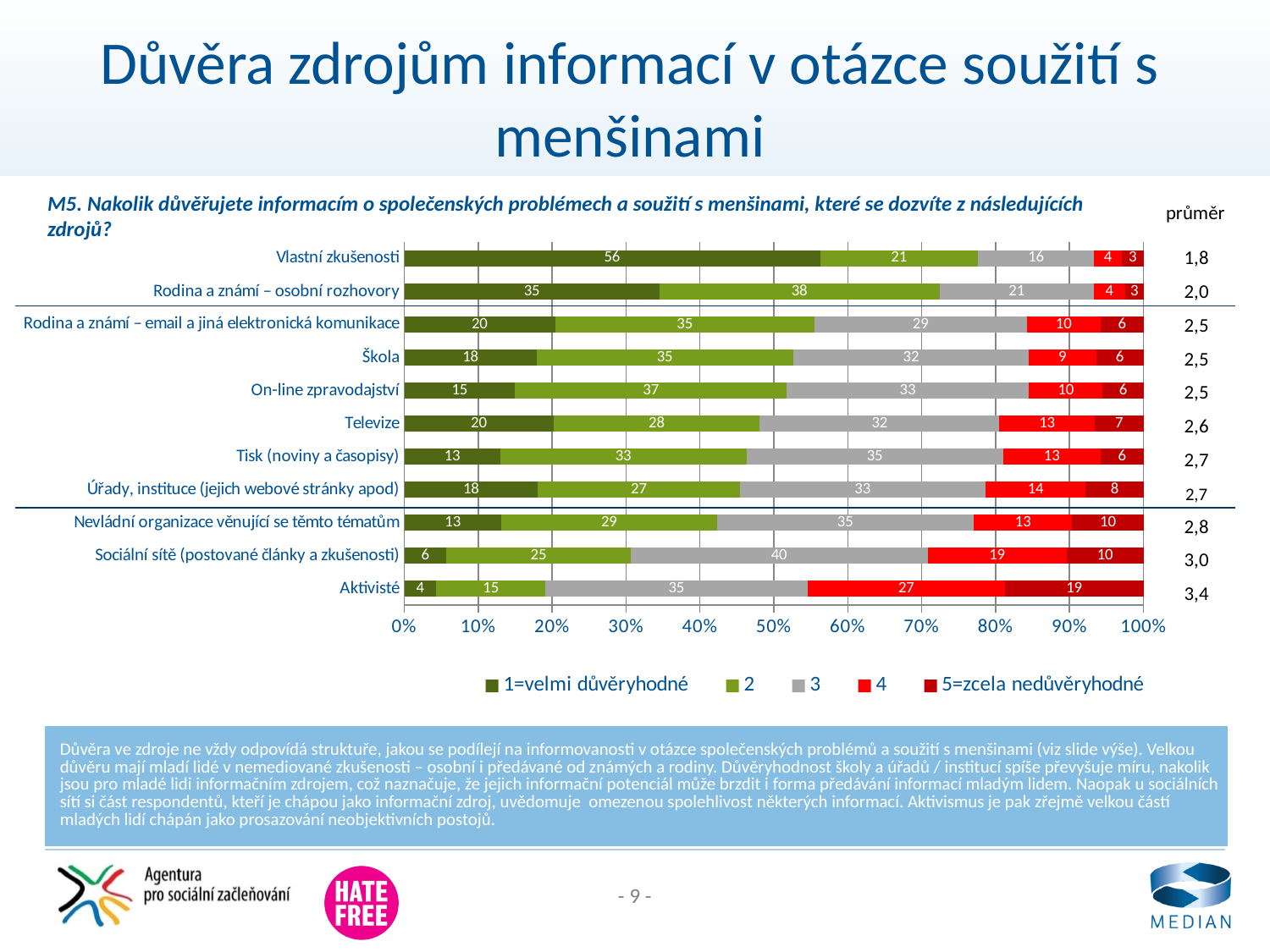
Which category has the highest "průměr" value? Aktivisté What is the value of the "5=zcela nedůvěryhodné" segment for "Aktivisté"? 19 What percentage of respondents rated "Vlastní zkušenosti" as "1=velmi důvěryhodné"? 56 What is the "průměr" value shown for "Sociální sítě (postované články a zkušenosti)"? 3,0 What is the difference between the "2" segment for "Rodina a známí – osobní rozhovory" and the "2" segment for "Televize"? 10 Which category has the largest "1=velmi důvěryhodné" segment? Vlastní zkušenosti Which category has the smallest "1=velmi důvěryhodné" segment? Aktivisté What is the total of the stacked bar for "Vlastní zkušenosti"? 100 How many series does the legend list? 5 How many information sources (categories) are shown in the chart? 11 Which has a larger "3" segment: "Sociální sítě (postované články a zkušenosti)" or "Škola"? Sociální sítě (postované články a zkušenosti) What type of chart is shown on the slide? Stacked bar chart